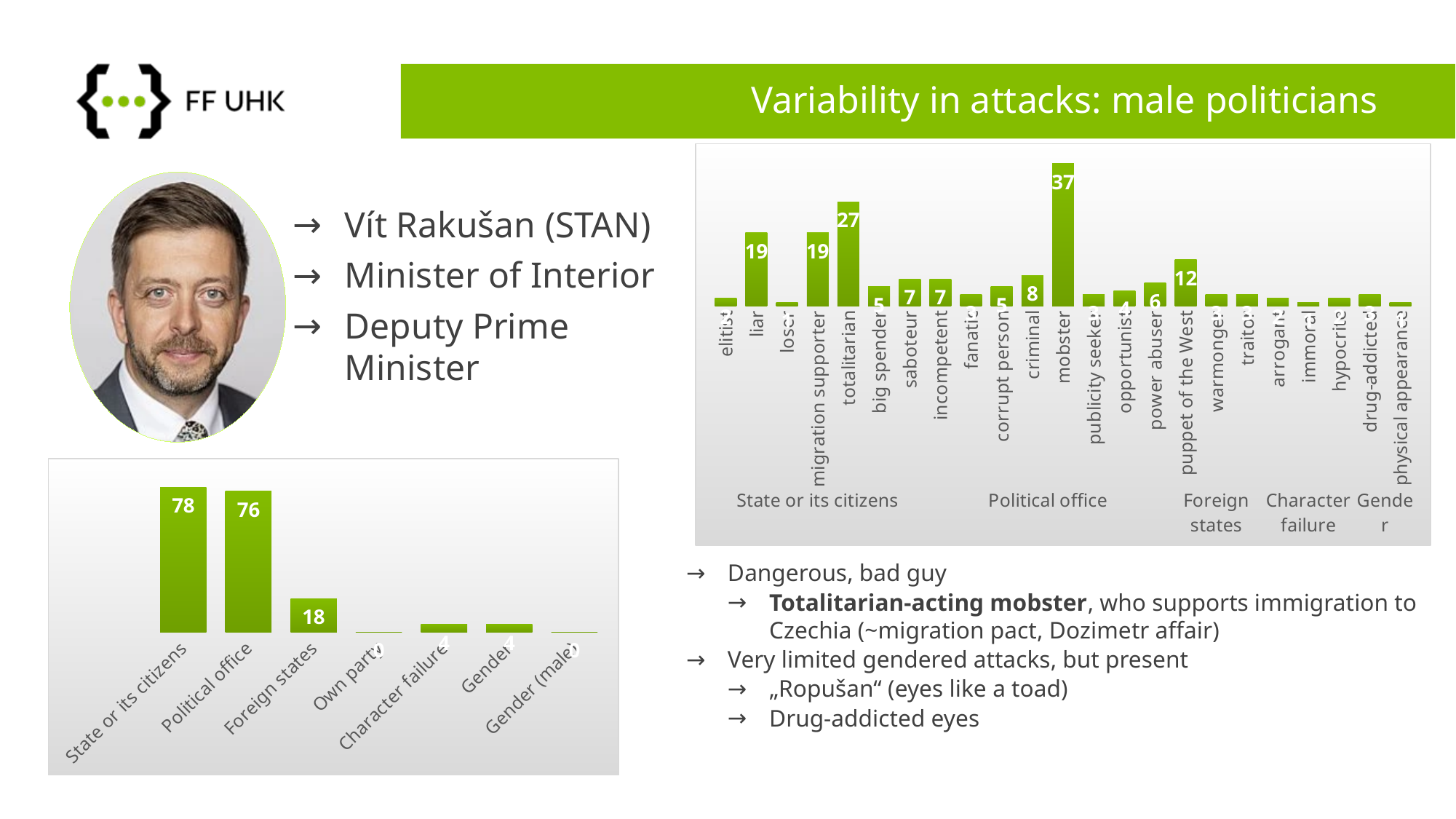
In the top-right chart, what is the difference between the values for mobster and totalitarian? 10 What kind of chart is the top-right chart? bar chart In the bottom-left chart, what is the difference between the values for State or its citizens and Political office? 2 In the bottom-left chart, how many categories are shown on the x axis? 7 In the top-right chart, what is the value for puppet of the West? 12 In the top-right chart, which is larger, the value for criminal or the value for saboteur? criminal In the bottom-left chart, what is the value for Foreign states? 18 In the top-right chart, which category has the highest value? mobster In the bottom-left chart, what is the value for State or its citizens? 78 In the bottom-left chart, what is the value for Political office? 76 In the bottom-left chart, which category has the highest value? State or its citizens In the top-right chart, what is the value for totalitarian? 27